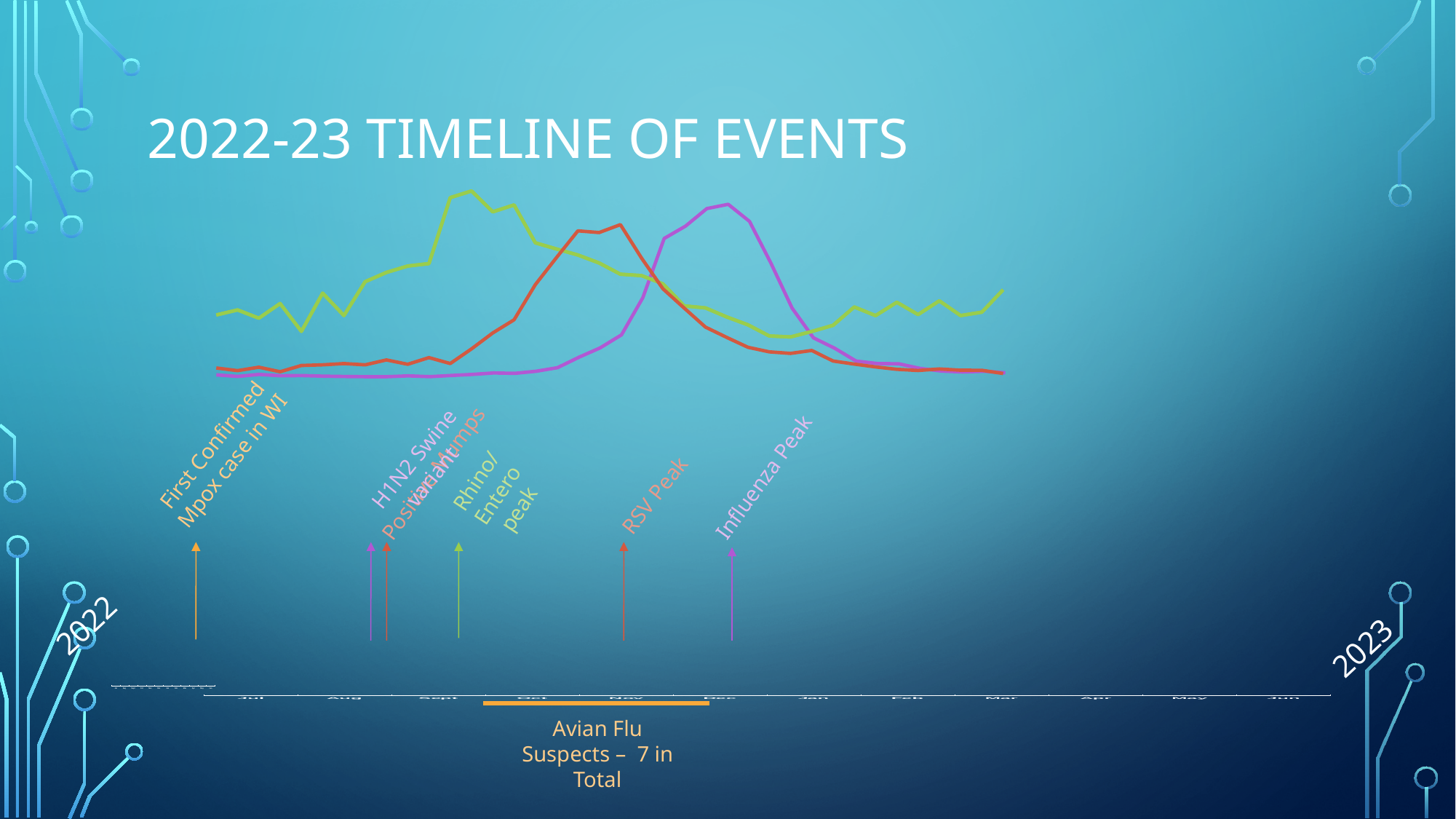
What kind of chart is shown on the slide? line chart Which line peaks last along the timeline: the green, the orange, or the purple line? purple Does the purple line rise or fall between its peak near Dec and Mar? fall Does the orange line rise or fall from Nov to Mar? fall What is the title of the slide containing the chart? 2022-23 Timeline of Events Which line peaks first along the timeline: the green, the orange, or the purple line? green How many months are labelled along the timeline axis? 12 How many lines are plotted on the chart? 3 How many Avian Flu suspects in total are noted on the timeline? 7 Which event is marked by the orange bar under the timeline between Oct and Dec? Avian Flu Suspects – 7 in Total Which peak is annotated with the purple arrow near Dec? Influenza Peak Does the green line rise or fall from Jul to its peak near Sept? rise